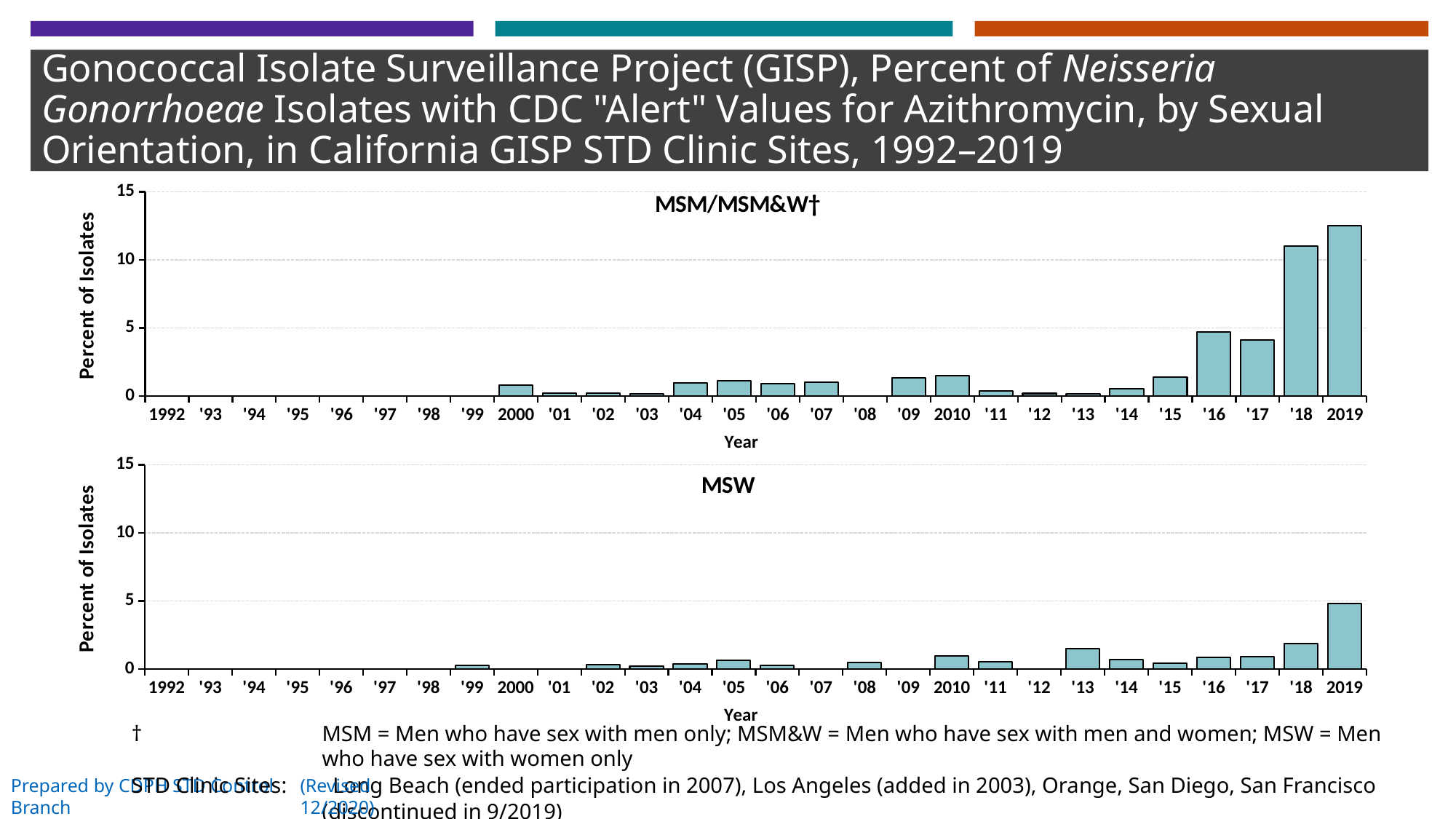
In the MSW chart, is the value for '13 greater or less than 5? less In the MSM/MSM&W† chart, do the values rise or fall from '17 to 2019? rise How many years are shown on the x axis of the MSW chart? 28 In the MSM/MSM&W† chart, which year has the highest percent of isolates? 2019 In the MSM/MSM&W† chart, is the value for '18 greater or less than 10? greater What is the y-axis label on the MSW chart? Percent of Isolates In the MSW chart, which year has the highest percent of isolates? 2019 What kind of chart is the MSM/MSM&W† chart at the top of the slide? bar chart Which is larger for 2019: the value in the MSM/MSM&W† chart or the value in the MSW chart? MSM/MSM&W† In the MSM/MSM&W† chart, is the value for 2019 greater or less than 10? greater In the MSM/MSM&W† chart, which is larger, the value for '17 or the value for '18? '18